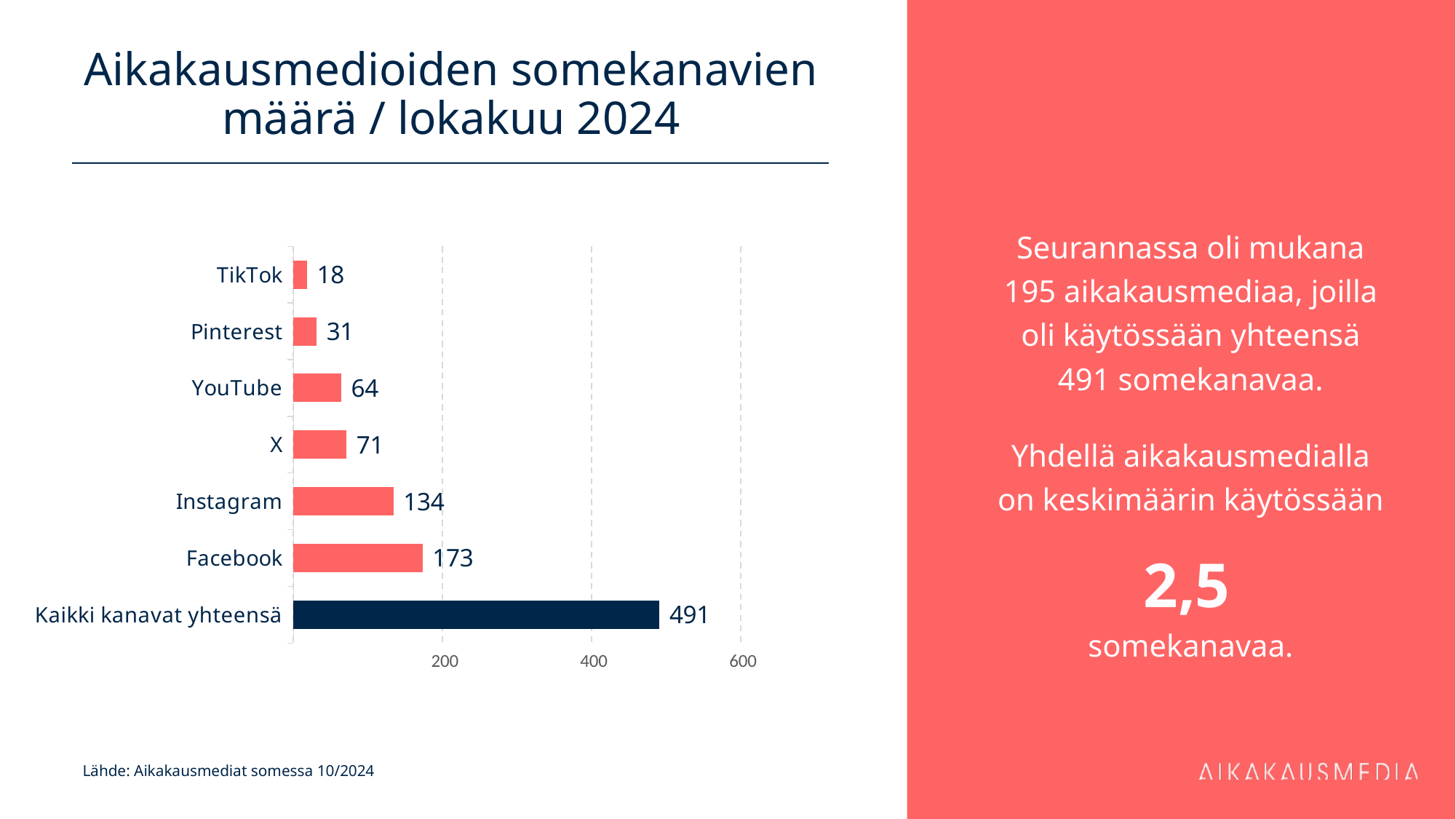
What kind of chart is shown on the slide? bar chart Which category has the lowest value? TikTok What is the value for Instagram? 134 What is the value for Facebook? 173 Is the value for Facebook greater or less than 200? less Which individual channel (excluding the total bar) has the highest value? Facebook What is the value for TikTok? 18 What is the title of the slide? Aikakausmedioiden somekanavien määrä / lokakuu 2024 What is the value for Kaikki kanavat yhteensä? 491 Which has a larger value, X or YouTube? X How many categories are shown in the chart? 7 What is the difference between the values for Facebook and Instagram? 39